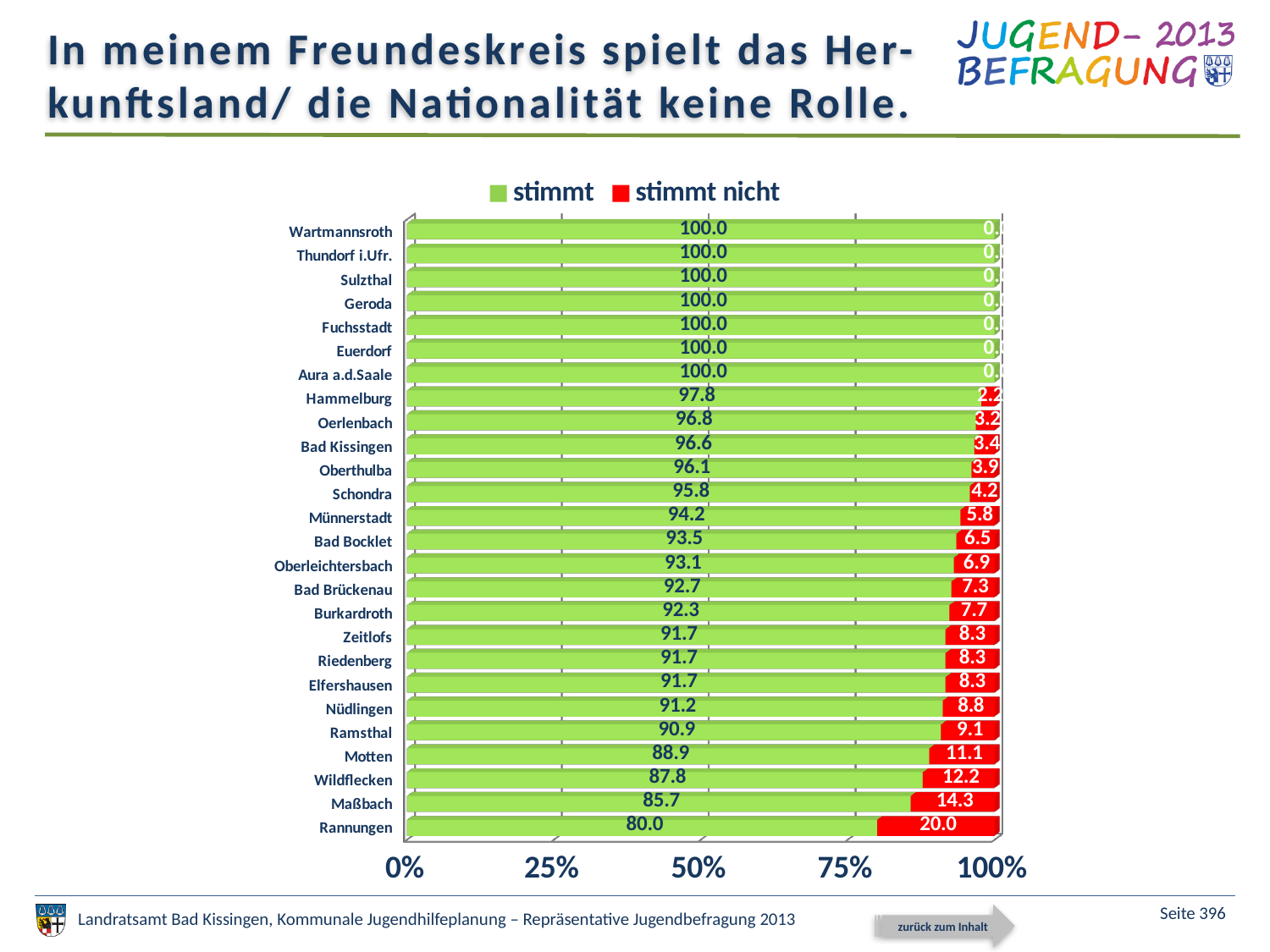
Which has the larger "stimmt" value, Münnerstadt or Bad Bocklet? Münnerstadt How many categories (municipalities) are shown in the chart? 26 What is the value of "stimmt nicht" for Maßbach? 14.3 What kind of chart is shown on the slide? Stacked bar chart How many series does the legend list? 2 What is the value of "stimmt nicht" for Oberthulba? 3.9 What colour represents the series "stimmt nicht" in the chart? Red Which category has the highest value for "stimmt nicht"? Rannungen What is the difference between the "stimmt" values for Motten and Wildflecken? 1.1 What is the value of "stimmt" for Hammelburg? 97.8 Which category has the lowest value for "stimmt"? Rannungen What is the value of "stimmt" for Rannungen? 80.0